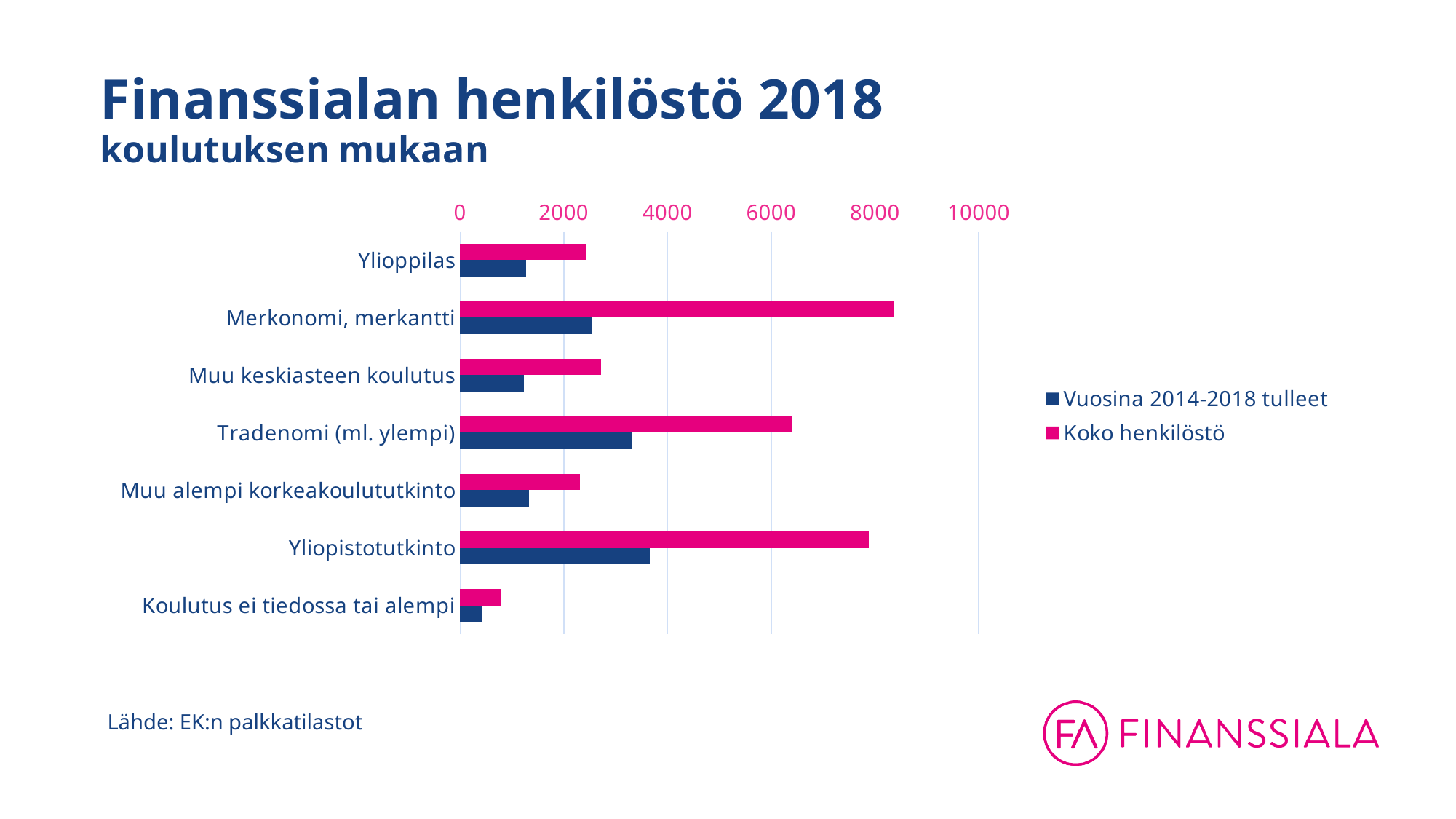
Is the Vuosina 2014-2018 tulleet value for Yliopistotutkinto greater or less than 4000? less Which category has the highest value for Koko henkilöstö? Merkonomi, merkantti Which category has the highest value for Vuosina 2014-2018 tulleet? Yliopistotutkinto What kind of chart is shown on the slide? bar chart Which category has the lowest value for Koko henkilöstö? Koulutus ei tiedossa tai alempi Is the Koko henkilöstö value for Yliopistotutkinto greater or less than 8000? less For Koko henkilöstö, which is larger: Tradenomi (ml. ylempi) or Ylioppilas? Tradenomi (ml. ylempi) Is the Koko henkilöstö value for Merkonomi, merkantti greater or less than 8000? greater How many education categories are shown on the chart? 7 Which series is shown in pink? Koko henkilöstö How many series does the legend list? 2